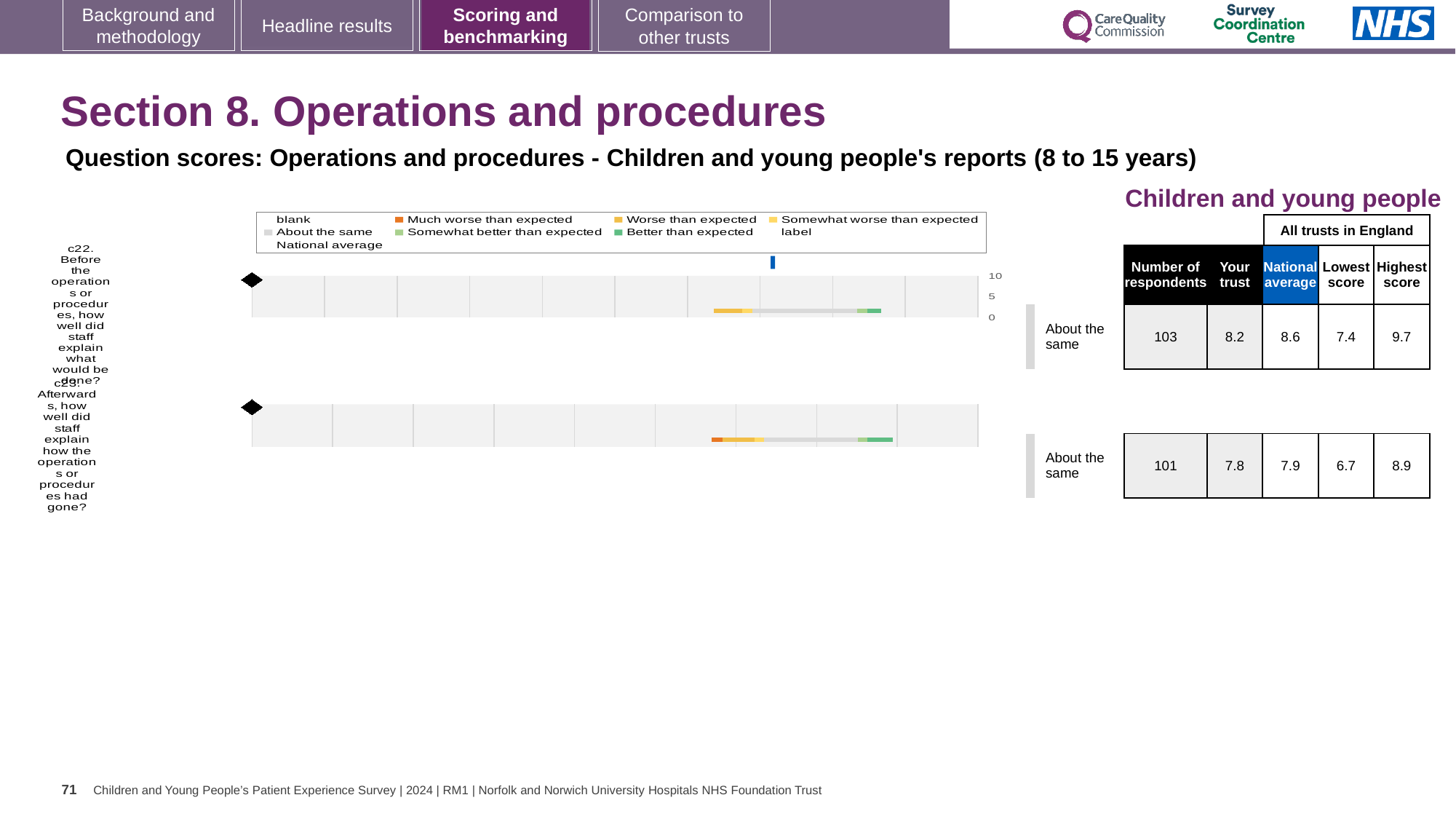
Which question has the higher 'Your trust' score, c22 or c23? c22 What is the 'Your trust' score for question c23 (Afterwards, how well did staff explain how the operations or procedures had gone?)? 7.8 How many survey questions are charted on the slide? 2 What benchmark category is shown for question c22 (Before the operations or procedures, how well did staff explain what would be done?)? About the same What is the 'Your trust' score for question c22? 8.2 What kind of chart is used to show the benchmark results for question c22? bar chart What is the difference between the highest score and the lowest score for question c22? 2.3 How many respondents answered question c23? 101 What is the highest score among all trusts in England for question c23? 8.9 In the chart legend, which colour represents 'Much worse than expected'? orange In the chart legend, which colour represents 'Better than expected'? green What is the national average score for question c22? 8.6